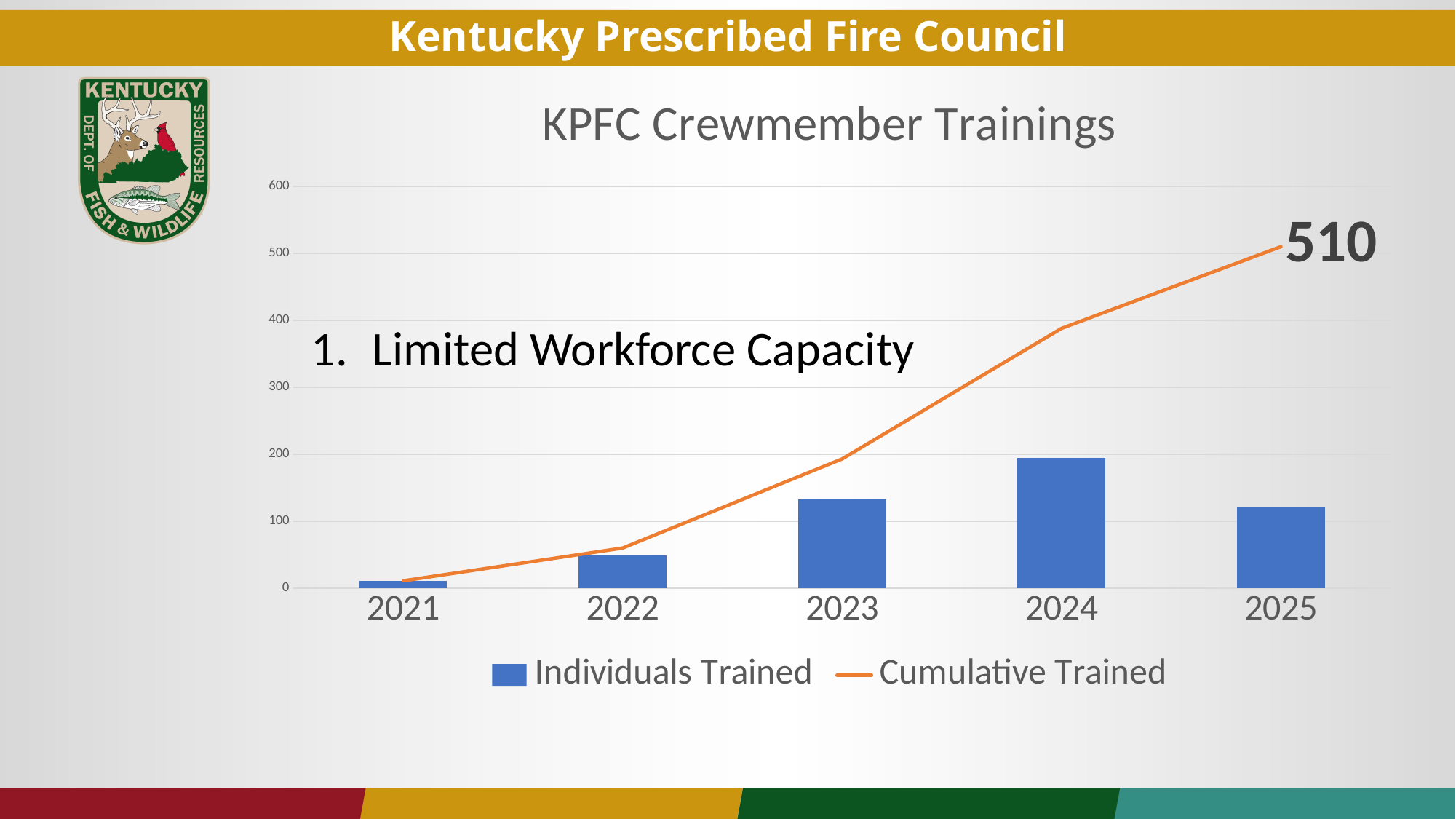
What is the Cumulative Trained value labeled for 2025? 510 How many years are shown on the x axis? 5 What kind of chart is this? Combined bar and line chart Is the Cumulative Trained value for 2024 greater or less than 300? greater Which year has the lowest Individuals Trained bar? 2021 Is the Individuals Trained value for 2024 greater or less than 100? greater Is the Individuals Trained value for 2022 greater or less than 100? less How many series does the legend list? 2 Does the Cumulative Trained line rise or fall from 2021 to 2025? Rises Which is larger, the Individuals Trained bar for 2024 or for 2023? 2024 What is the title of the chart? KPFC Crewmember Trainings Which year has the highest Individuals Trained bar? 2024